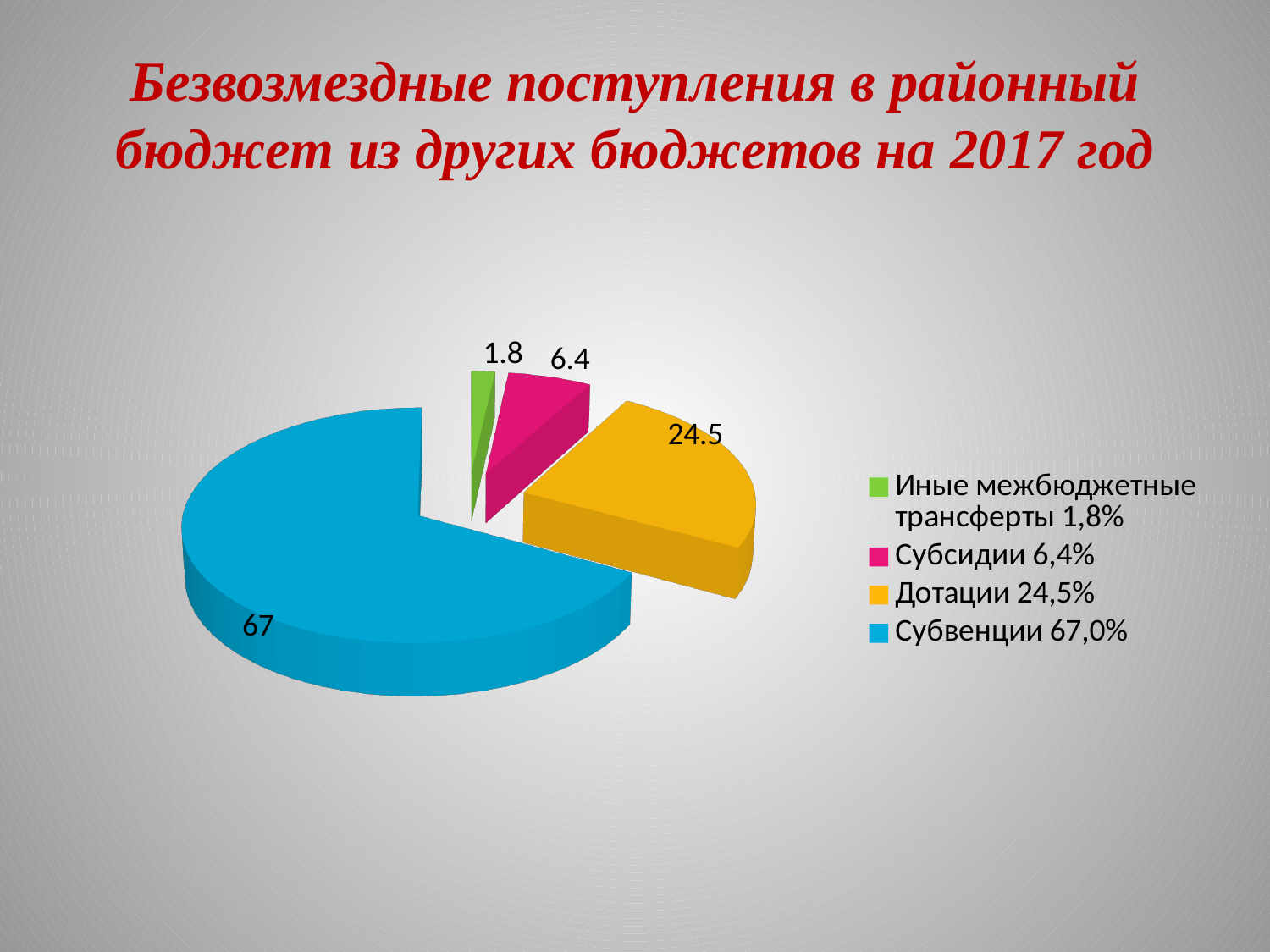
What share of the pie does Субвенции represent according to the legend? 67,0% How many slices does the pie chart have? 4 What is the difference between the Субвенции value and the Дотации value? 42.5 Which slice is larger, Дотации or Субсидии? Дотации What is the data label on the Иные межбюджетные трансферты slice? 1.8 What kind of chart is shown on the slide? Pie chart What colour is the Дотации slice? Yellow What is the data label on the Дотации slice? 24.5 What is the data label on the Субсидии slice? 6.4 What is the data label on the Субвенции slice? 67 Which category has the largest slice of the pie? Субвенции Which category has the smallest slice of the pie? Иные межбюджетные трансферты